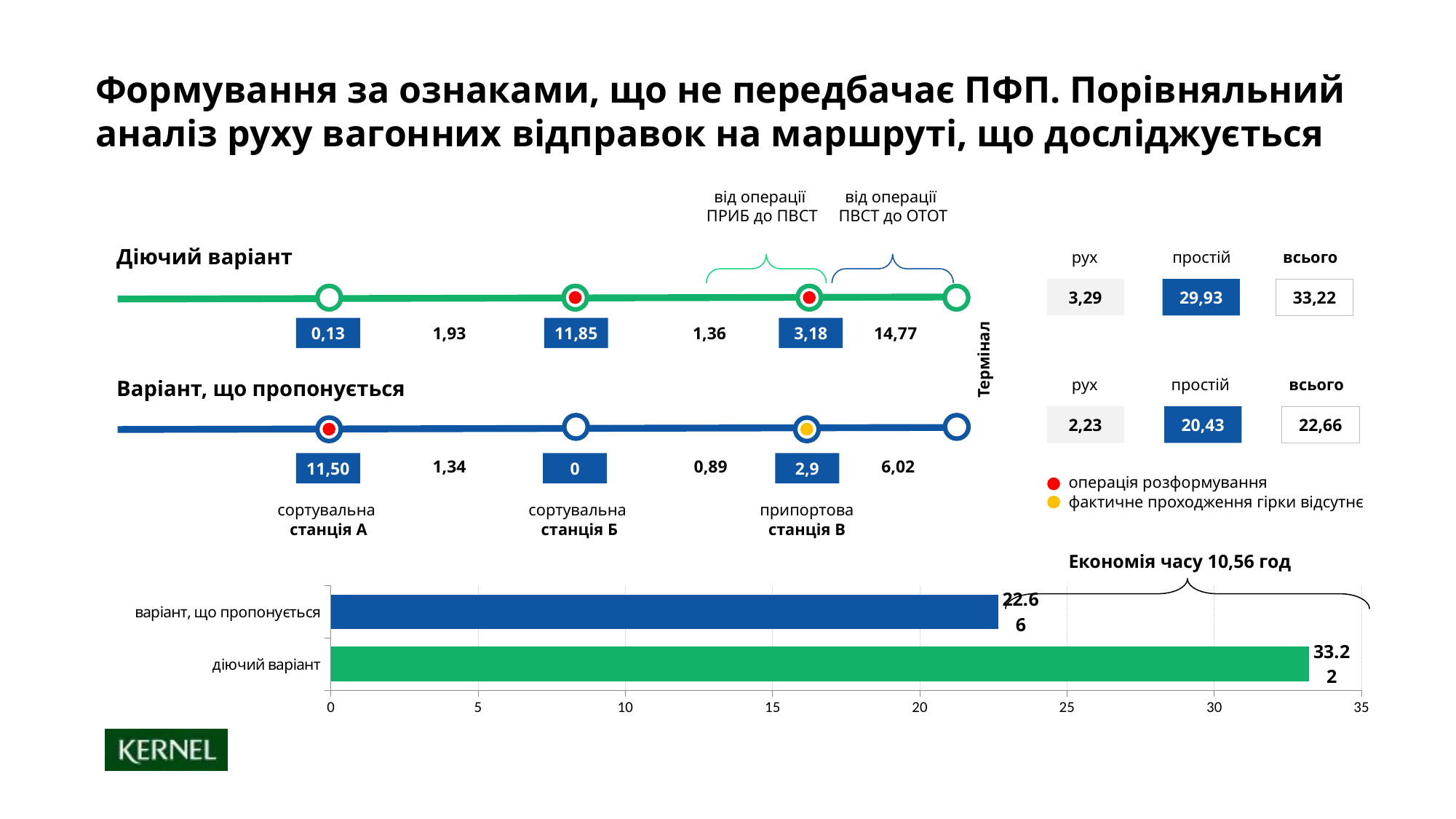
What kind of chart is shown at the bottom of the slide? bar chart In the bar chart at the bottom, what is the value for варіант, що пропонується? 22.66 How many bars does the bar chart at the bottom of the slide have? 2 In the bar chart at the bottom, what is the highest tick value shown on the x axis? 35 In the bar chart at the bottom, what is the value for діючий варіант? 33.22 In the bar chart at the bottom, which category has the highest value? діючий варіант In the bar chart at the bottom, which category has the lowest value? варіант, що пропонується In the bar chart at the bottom, what colour is the bar for діючий варіант? green In the bar chart at the bottom, which is larger: the value for діючий варіант or the value for варіант, що пропонується? діючий варіант In the bar chart at the bottom, what is the difference between the values for діючий варіант and варіант, що пропонується? 10.56 In the bar chart at the bottom, is the value for діючий варіант greater or less than 30? greater In the bar chart at the bottom, is the value for варіант, що пропонується greater or less than 25? less